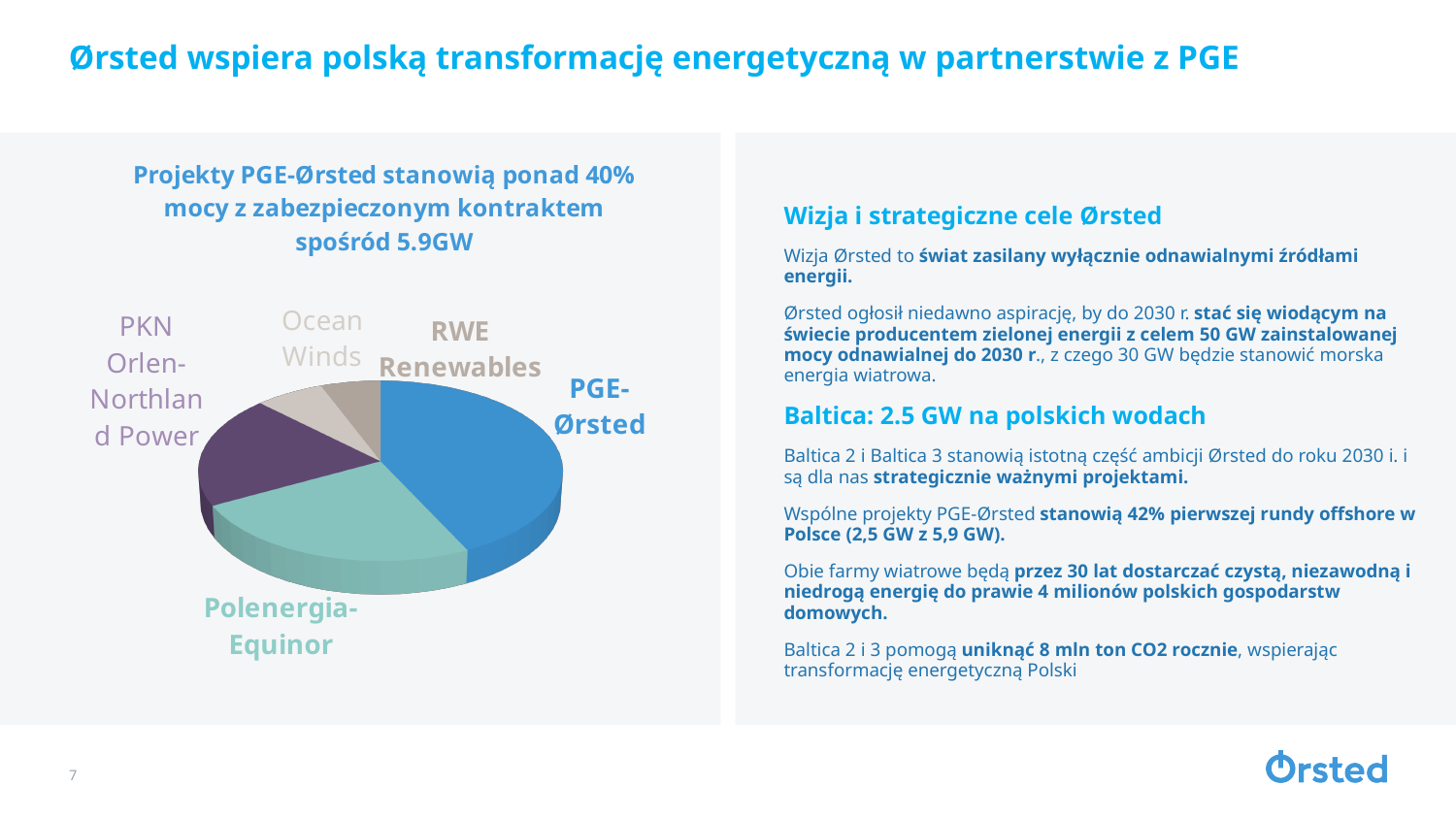
What kind of chart is shown on the slide? pie chart Which slice is larger, PKN Orlen-Northland Power or Ocean Winds? PKN Orlen-Northland Power How many slices does the pie chart have? 5 What is the title of the pie chart? Projekty PGE-Ørsted stanowią ponad 40% mocy z zabezpieczonym kontraktem spośród 5.9GW What colour is the PGE-Ørsted slice in the pie chart? blue Which slice is larger, PGE-Ørsted or RWE Renewables? PGE-Ørsted Which slice is larger, Polenergia-Equinor or PKN Orlen-Northland Power? Polenergia-Equinor Which category has the largest slice in the pie chart? PGE-Ørsted